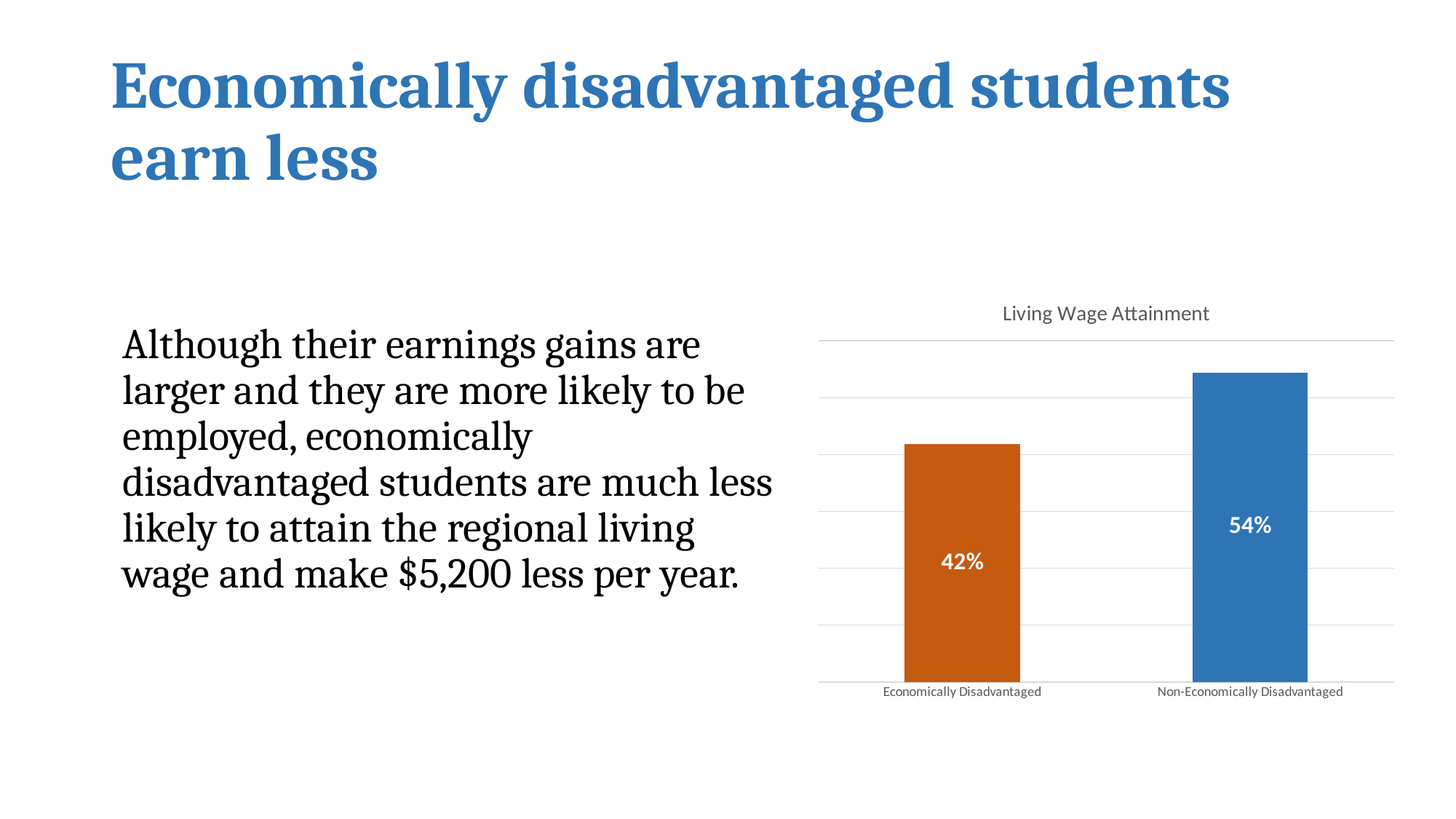
What is the difference in living wage attainment between Non-Economically Disadvantaged and Economically Disadvantaged students? 12% What kind of chart is shown on the slide? Bar chart Which category has the highest living wage attainment? Non-Economically Disadvantaged What colour is the bar for Economically Disadvantaged students? Orange What is the title of the chart? Living Wage Attainment Which is larger: the value for Economically Disadvantaged or for Non-Economically Disadvantaged? Non-Economically Disadvantaged What is the living wage attainment value for Non-Economically Disadvantaged students? 54% How many categories are shown in the chart? 2 Which category has the lowest living wage attainment? Economically Disadvantaged What is the living wage attainment value for Economically Disadvantaged students? 42%